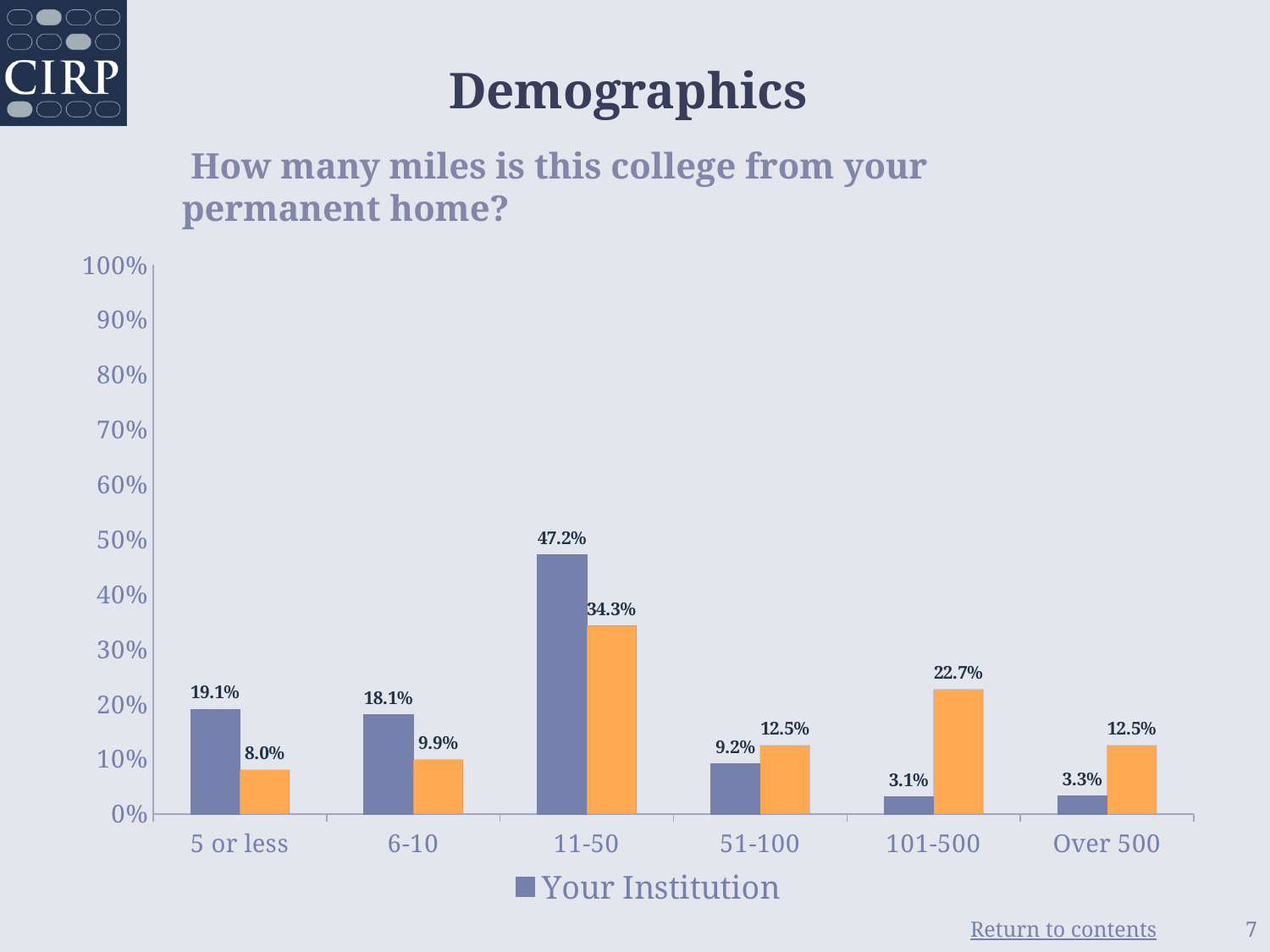
What is the Your Institution value for the '5 or less' miles category? 19.1% Which distance category has the lowest Your Institution value? 101-500 What series name is listed in the chart legend? Your Institution Is the Your Institution value for 11-50 miles greater or less than 40%? greater What is the value of the orange bar for the 101-500 miles category? 22.7% What is the difference between the Your Institution value and the orange bar value for the 11-50 miles category? 12.9% What type of chart is shown on the slide? bar chart How many distance categories are shown on the x axis? 6 What percentage of Your Institution respondents live 11-50 miles from the college? 47.2% For the 101-500 miles category, which is larger: the Your Institution bar or the orange bar? the orange bar Which distance category has the highest Your Institution value? 11-50 Which distance category has the lowest value for the orange series? 5 or less